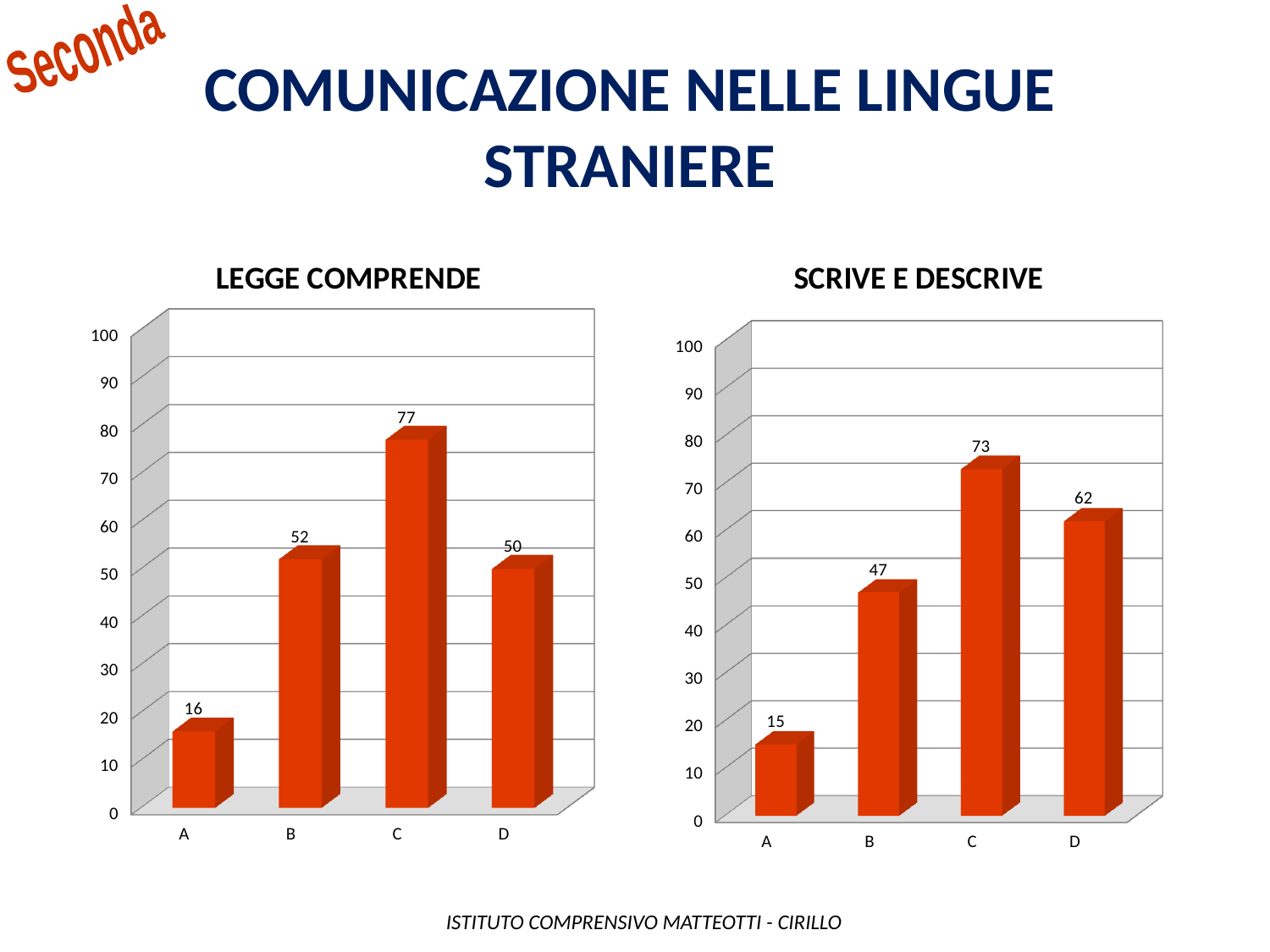
In the LEGGE COMPRENDE chart, what is the value for category C? 77 In the LEGGE COMPRENDE chart, what is the difference between the values for C and A? 61 In the SCRIVE E DESCRIVE chart, is the value for A greater or less than 20? less In the LEGGE COMPRENDE chart, what is the value for category B? 52 What is the title of the chart on the right side of the slide? SCRIVE E DESCRIVE In the LEGGE COMPRENDE chart, which is larger, the value for B or the value for D? B How many categories are shown in the LEGGE COMPRENDE chart? 4 What kind of chart is the SCRIVE E DESCRIVE chart? bar chart In the SCRIVE E DESCRIVE chart, what is the difference between the values for C and B? 26 In the SCRIVE E DESCRIVE chart, which category has the highest value? C In the SCRIVE E DESCRIVE chart, what is the value for category D? 62 In the LEGGE COMPRENDE chart, which category has the lowest value? A